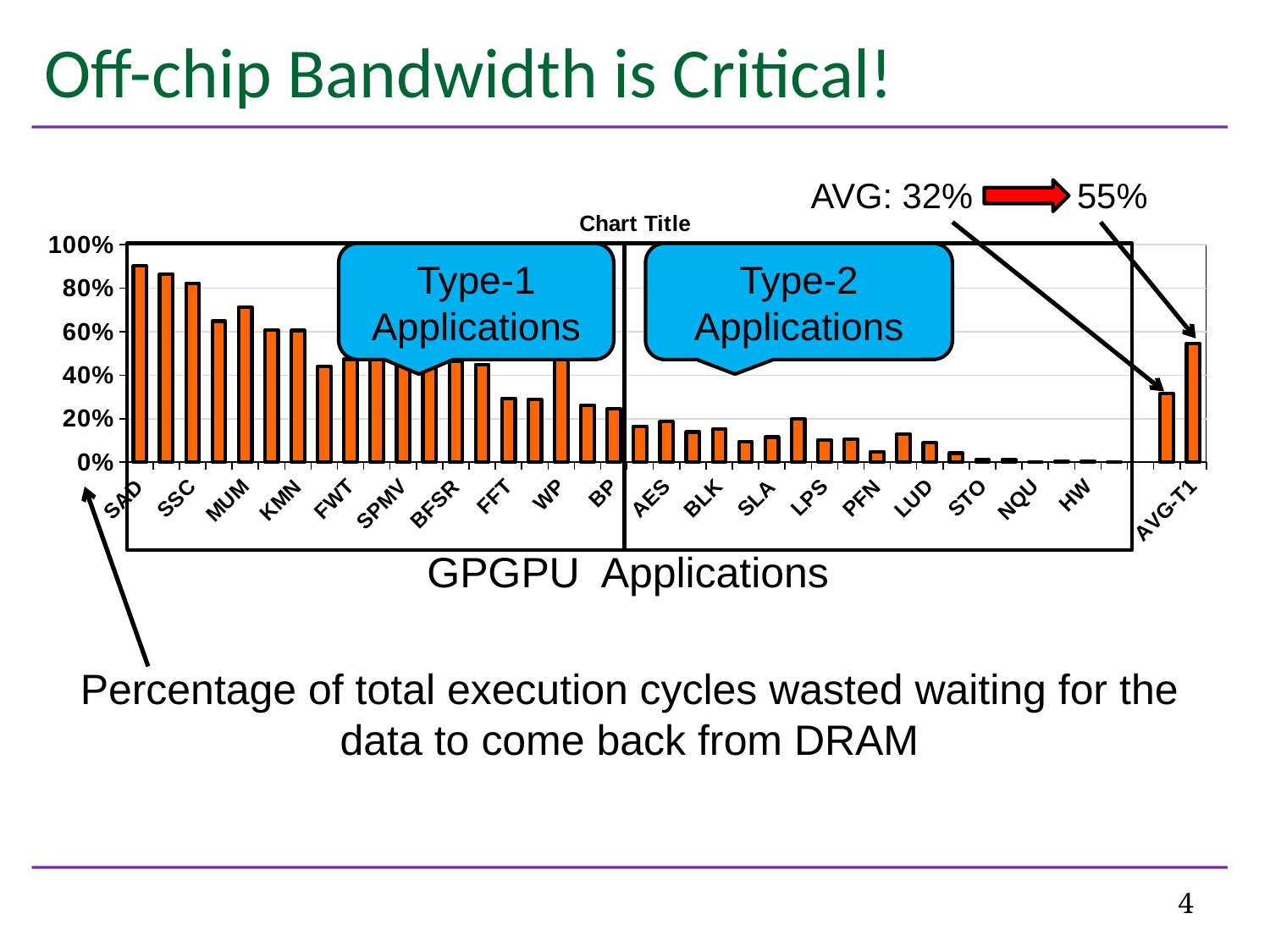
Is the value for FFT greater or less than 20%? greater Which application has the highest bar in the chart? SAD Is the value for FWT greater or less than 40%? greater According to the annotation, what is the average value for the AVG-T1 bar? 55% What is the x-axis label of the chart? GPGPU Applications Is the value for MUM greater or less than 60%? greater Which is larger, the value for BLK or the value for SSC? SSC Which is larger, the value for SAD or the value for AES? SAD What kind of chart is shown on the slide? bar chart